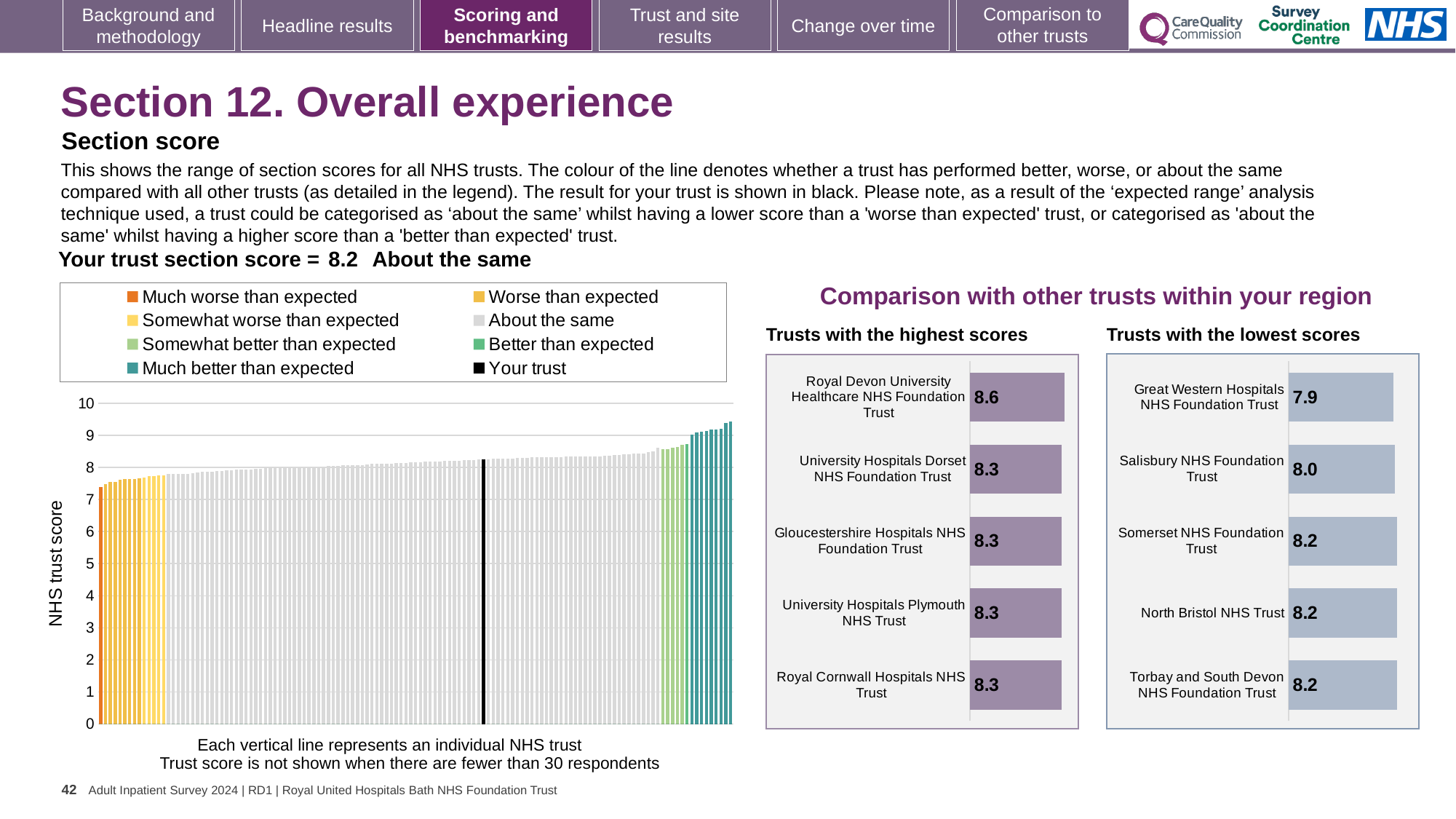
In the large chart on the left showing all NHS trusts, how many entries does the legend list? 8 In the 'Trusts with the highest scores' chart, what is the difference between the scores of Royal Devon University Healthcare NHS Foundation Trust and University Hospitals Dorset NHS Foundation Trust? 0.3 How many trusts are shown in the 'Trusts with the highest scores' chart? 5 In the 'Trusts with the highest scores' chart, what is the score for Royal Devon University Healthcare NHS Foundation Trust? 8.6 In the 'Trusts with the lowest scores' chart, what is the score for Salisbury NHS Foundation Trust? 8.0 In the 'Trusts with the lowest scores' chart, which trust has the lowest score? Great Western Hospitals NHS Foundation Trust What kind of chart is the large chart on the left showing all NHS trusts? Bar chart Which is larger: the score for Salisbury NHS Foundation Trust in the lowest scores chart or the score for Royal Cornwall Hospitals NHS Trust in the highest scores chart? Royal Cornwall Hospitals NHS Trust In the 'Trusts with the lowest scores' chart, what is the score for Great Western Hospitals NHS Foundation Trust? 7.9 What is the difference between the score for Royal Devon University Healthcare NHS Foundation Trust in the highest scores chart and the score for Great Western Hospitals NHS Foundation Trust in the lowest scores chart? 0.7 In the 'Trusts with the highest scores' chart, which trust has the highest score? Royal Devon University Healthcare NHS Foundation Trust In the large chart on the left showing all NHS trusts, do the bar values rise or fall from left to right? Rise